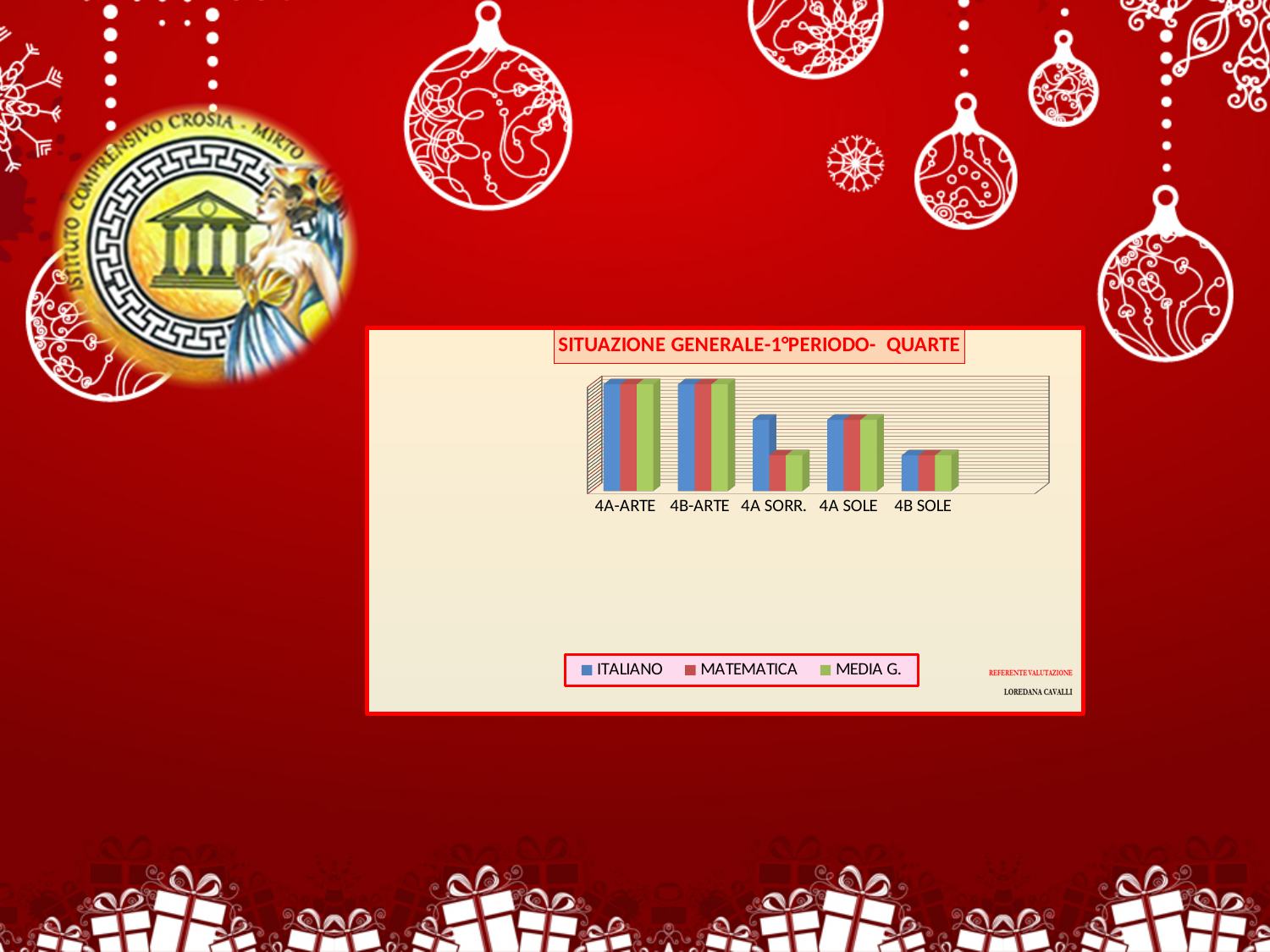
What is the title of the chart? SITUAZIONE GENERALE-1°PERIODO- QUARTE Which has the larger ITALIANO value: 4A SOLE or 4B SOLE? 4A SOLE Which has the larger MEDIA G. value: 4B-ARTE or 4A SOLE? 4B-ARTE What kind of chart is shown on the slide? bar chart Which series are listed in the chart's legend? ITALIANO, MATEMATICA, MEDIA G. How many categories are shown on the x axis of the chart? 5 How many series does the chart's legend list? 3 Which category has the lowest ITALIANO value? 4B SOLE Which has the larger ITALIANO value: 4A-ARTE or 4A SORR.? 4A-ARTE